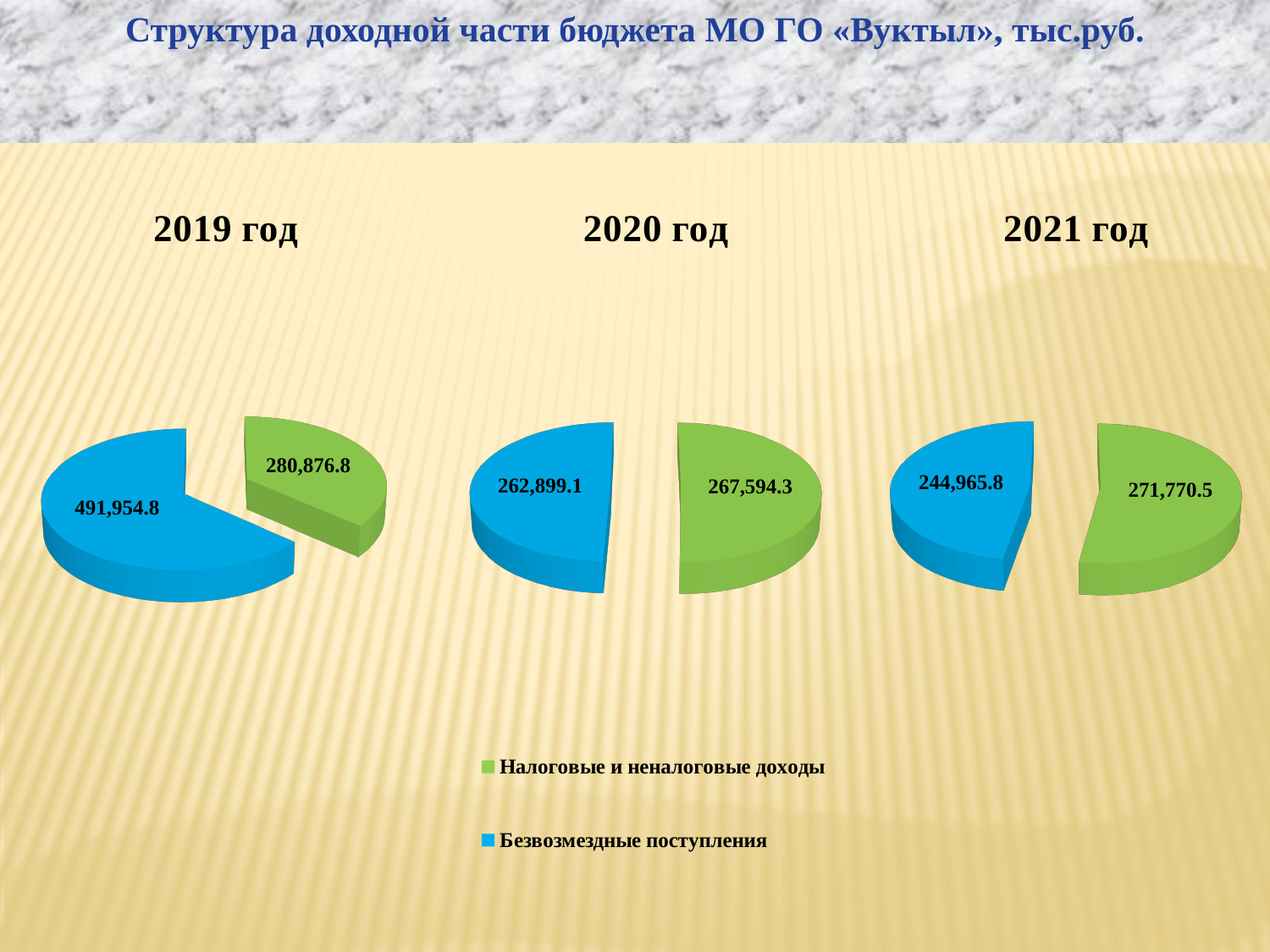
In the 2021 год pie chart, what is the difference between Налоговые и неналоговые доходы and Безвозмездные поступления? 26,804.7 In the 2019 год pie chart, which category has the largest slice? Безвозмездные поступления In the 2020 год pie chart, which is larger: Налоговые и неналоговые доходы or Безвозмездные поступления? Налоговые и неналоговые доходы How many categories does the legend list? 2 In the 2021 год pie chart, what is the value for Безвозмездные поступления? 244,965.8 In the 2019 год pie chart, what is the difference between Безвозмездные поступления and Налоговые и неналоговые доходы? 211,078.0 In the 2021 год pie chart, which category has the smallest slice? Безвозмездные поступления In the 2020 год pie chart, what is the total of the two slices? 530,493.4 In the 2019 год pie chart, what is the value for Налоговые и неналоговые доходы? 280,876.8 In the 2020 год pie chart, what is the value for Налоговые и неналоговые доходы? 267,594.3 What kind of chart is used for each year on the slide? Pie chart In the 2019 год pie chart, what is the value for Безвозмездные поступления? 491,954.8